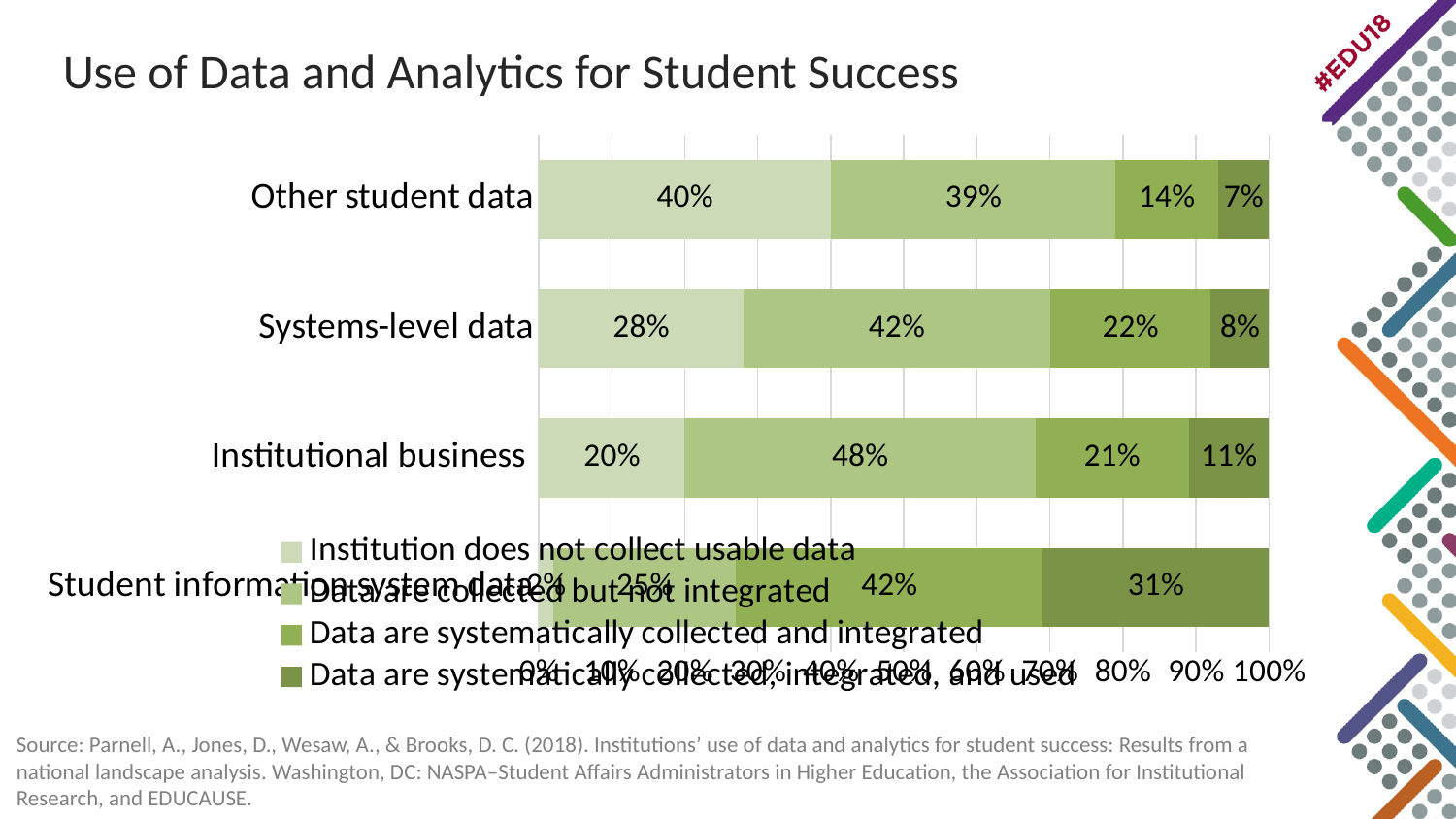
How many series does the legend list? 4 What percentage of institutions report that Systems-level data are collected but not integrated? 42% Which category has the highest share of institutions that do not collect usable data? Other student data Which category has the lowest share of institutions reporting data are systematically collected, integrated, and used? Other student data What percentage of institutions report that Student information system data are systematically collected, integrated, and used? 31% What percentage of institutions report that Institutional business data are systematically collected, integrated, and used? 11% What kind of chart is shown on the slide? Stacked bar chart What is the difference between the 'Data are collected but not integrated' values for Institutional business and Other student data? 9% What is the title of the chart? Use of Data and Analytics for Student Success What percentage of institutions do not collect usable data for Other student data? 40% Which is larger: the 'Data are systematically collected and integrated' value for Systems-level data or for Institutional business? Systems-level data How many categories are plotted on the chart? 4